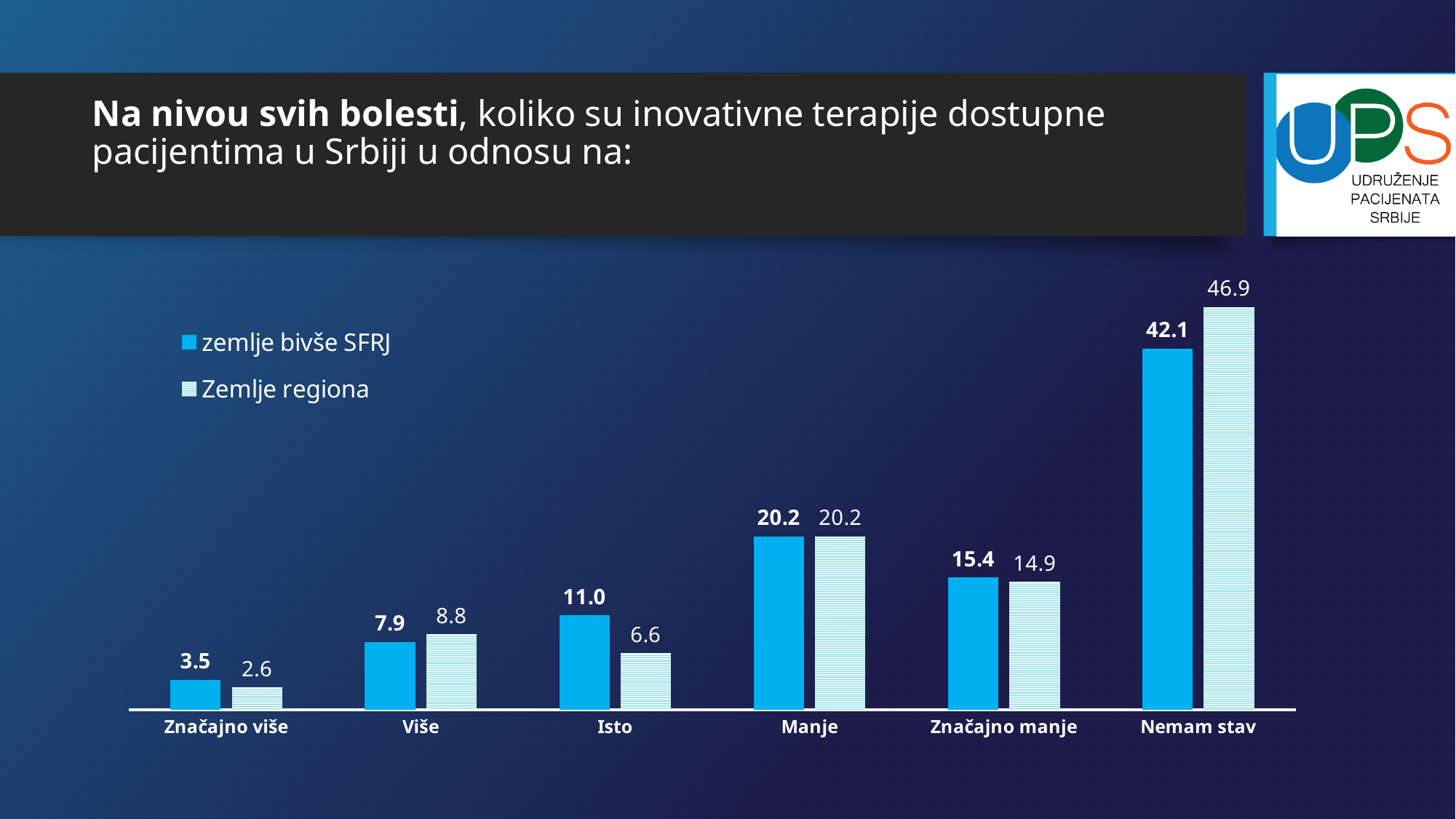
Which category has the highest value in the "Zemlje regiona" series? Nemam stav How many categories are shown on the x axis of the chart? 6 What is the value for "Isto" in the "Zemlje regiona" series? 6.6 What is the value for "Nemam stav" in the "zemlje bivše SFRJ" series? 42.1 What is the difference between the "zemlje bivše SFRJ" and "Zemlje regiona" values for "Isto"? 4.4 What is the difference between the "Zemlje regiona" and "zemlje bivše SFRJ" values for "Nemam stav"? 4.8 How many series does the legend list? 2 Which category has the lowest value in the "zemlje bivše SFRJ" series? Značajno više What is the value for "Više" in the "zemlje bivše SFRJ" series? 7.9 For "Značajno manje", which series has the larger value: "zemlje bivše SFRJ" or "Zemlje regiona"? zemlje bivše SFRJ What kind of chart is shown on the slide? Bar chart For "Više", which series has the larger value: "zemlje bivše SFRJ" or "Zemlje regiona"? Zemlje regiona